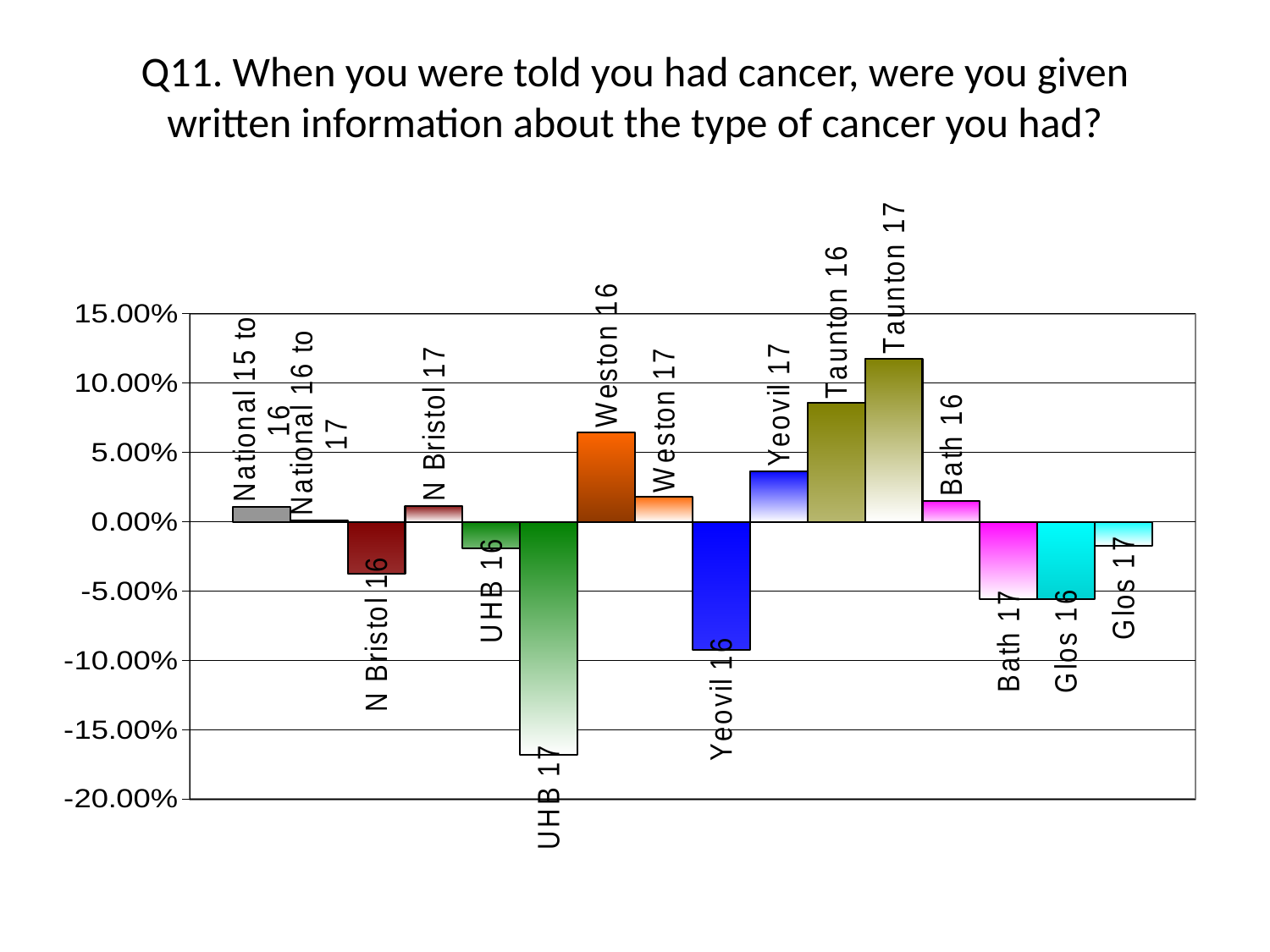
Is the value for Weston 16 greater or less than 5.00%? greater What kind of chart is shown on the slide? bar chart Is the value for Yeovil 16 greater or less than -5.00%? less Which category has the lowest value in the chart? UHB 17 Which category has the highest value in the chart? Taunton 17 Which is larger, the value for Taunton 16 or Taunton 17? Taunton 17 Is the value for UHB 17 greater or less than -15.00%? less How many bars (categories) are plotted in the chart? 16 Which is larger, the value for Yeovil 16 or Yeovil 17? Yeovil 17 What is the title of the chart on the slide? Q11. When you were told you had cancer, were you given written information about the type of cancer you had? Which is larger, the value for Weston 16 or Weston 17? Weston 16